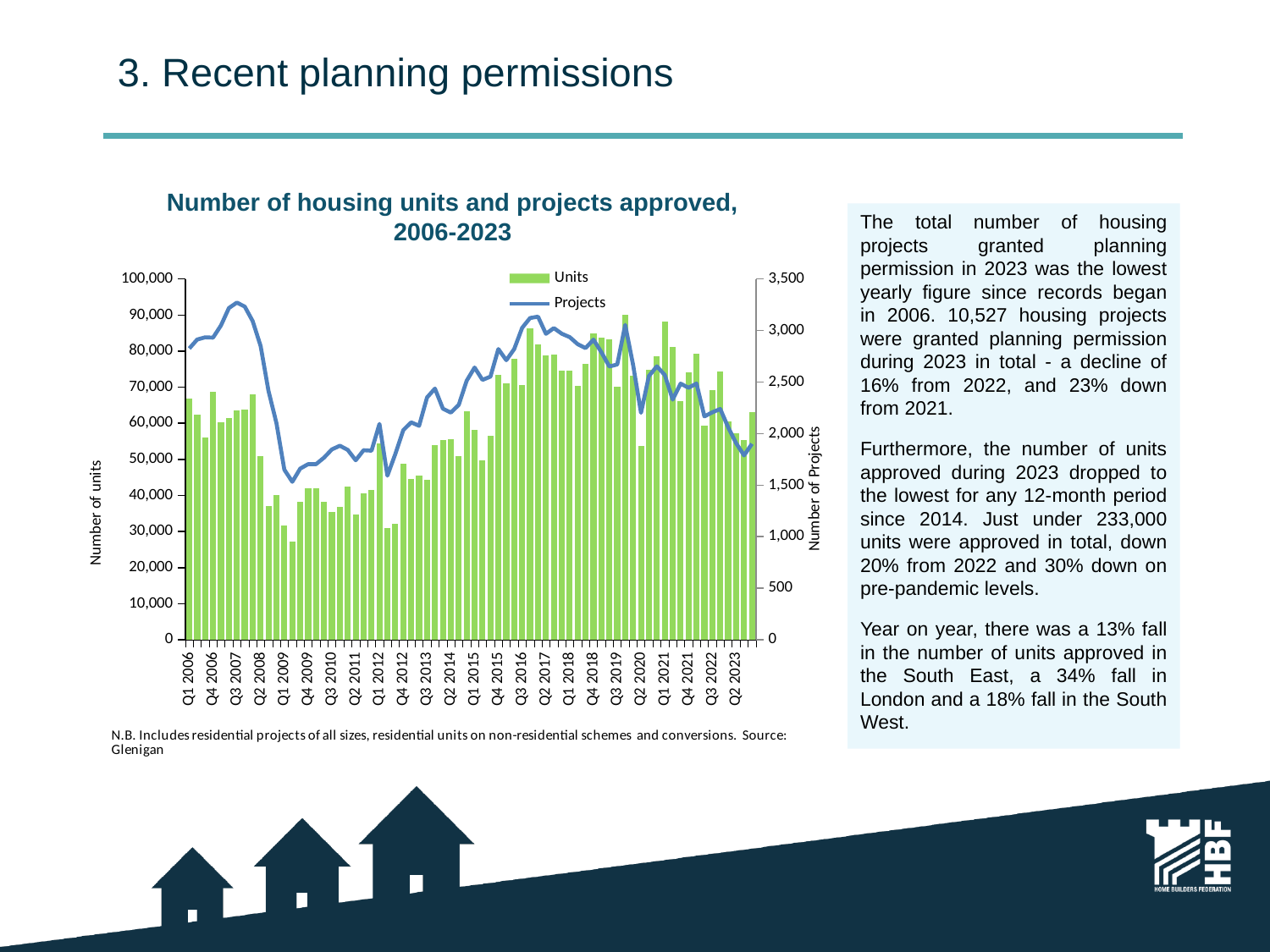
Does the Projects line rise or fall between Q3 2007 and Q1 2009? Falls Which two series are listed in the chart legend? Units and Projects How many series does the chart legend list? 2 Which quarter has the lowest number of units approved? Q2 2009 Is the number of units approved in Q2 2023 greater or less than 50,000? greater Is the number of units approved in Q1 2006 greater or less than 60,000? greater Is the number of projects approved in Q3 2007 greater or less than 3,000? greater What kind of chart is shown on the slide? A combined bar and line chart Which is larger, the number of units approved in Q1 2006 or in Q1 2009? Q1 2006 What is the title of the chart? Number of housing units and projects approved, 2006-2023